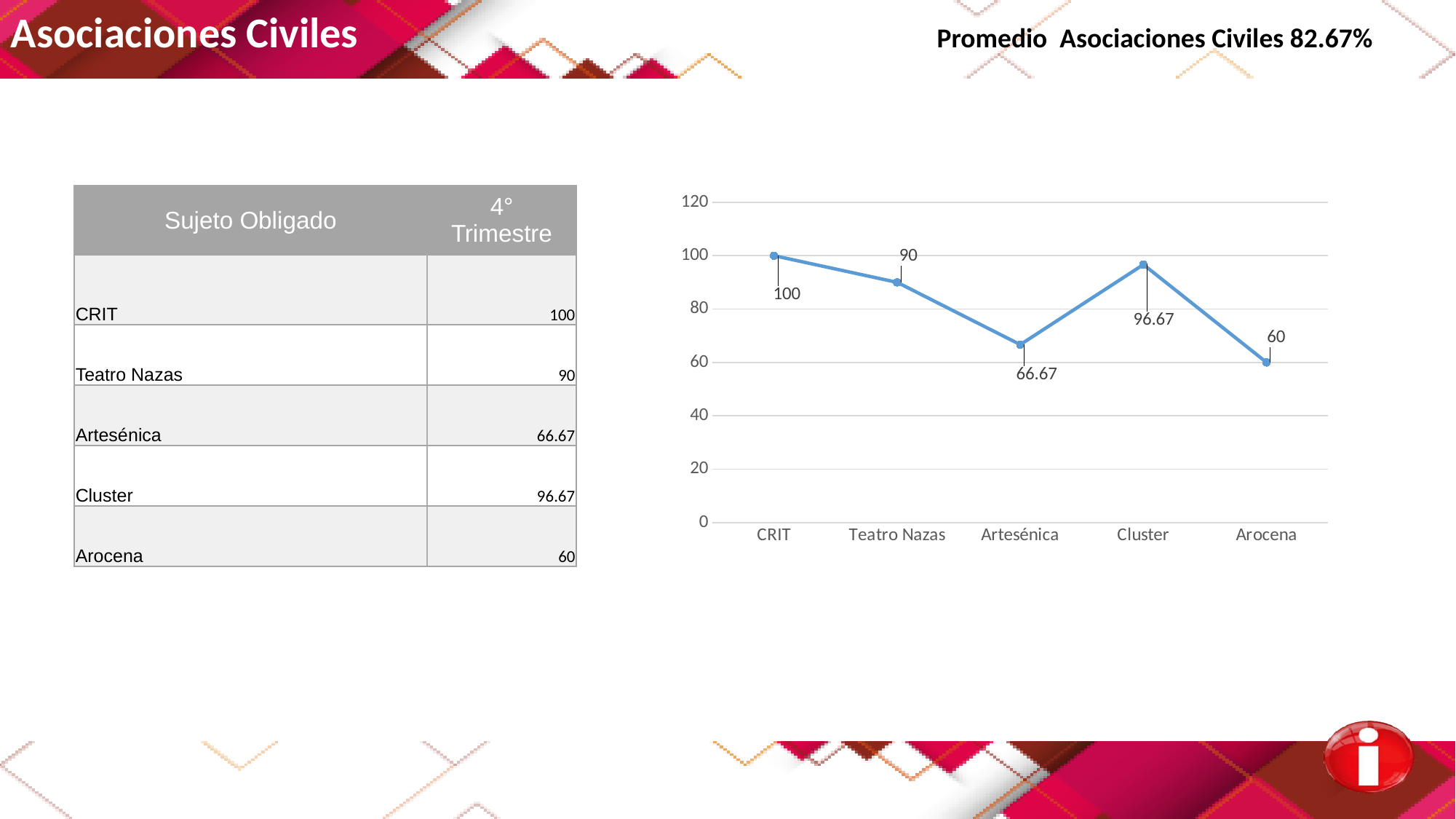
What kind of chart is shown on the slide? line chart Which category has the highest value in the chart? CRIT How many categories are plotted on the x axis of the chart? 5 What is the value plotted for Artesénica? 66.67 What is the difference between the values for CRIT and Arocena? 40 Which is larger, the value for Teatro Nazas or the value for Artesénica? Teatro Nazas What is the value plotted for Arocena? 60 What is the difference between the values for Cluster and Artesénica? 30 Which category has the lowest value in the chart? Arocena What is the value plotted for CRIT? 100 Does the value rise or fall from Cluster to Arocena? fall What is the value plotted for Cluster? 96.67